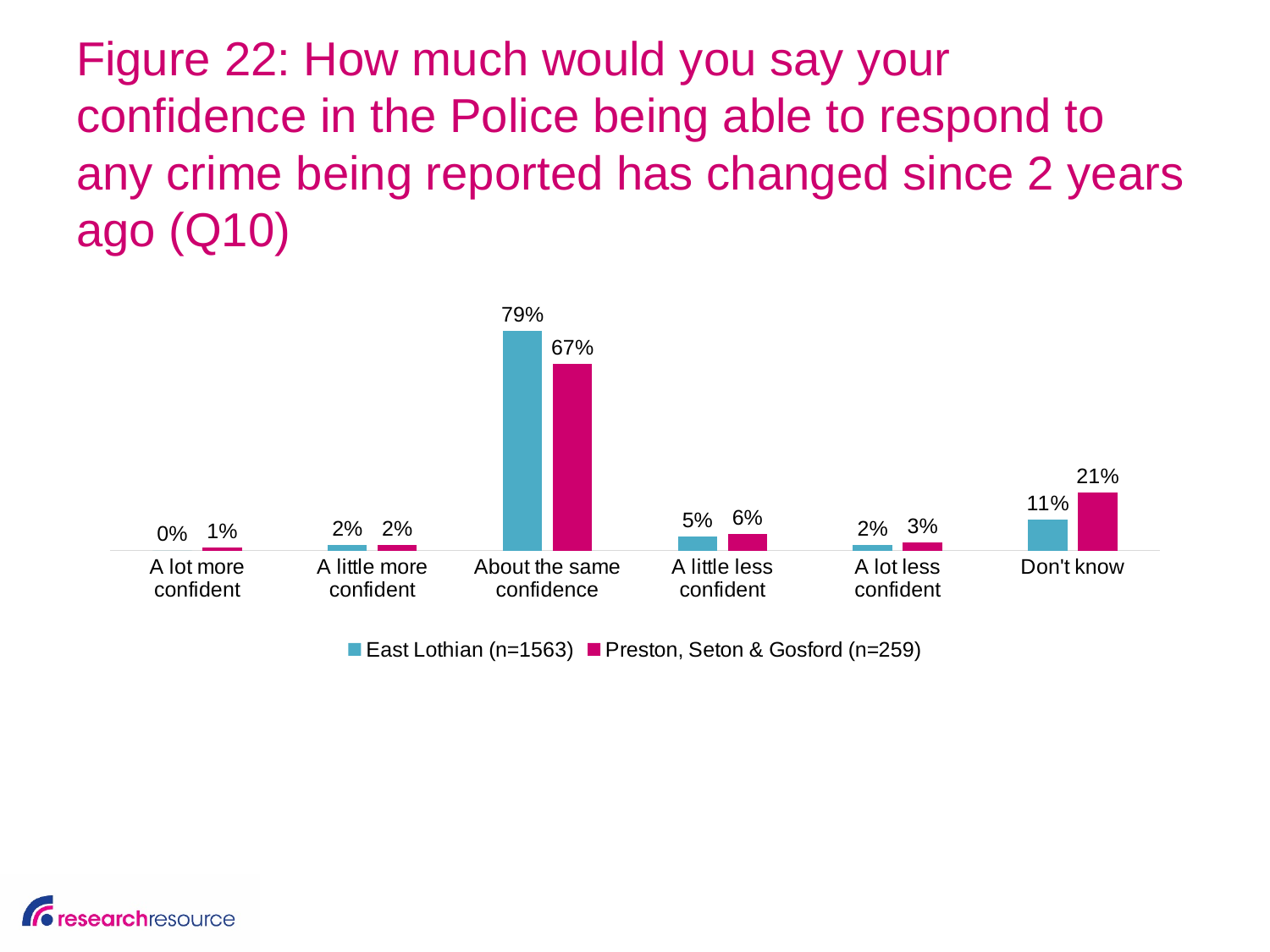
How many response categories are shown on the x axis? 6 What is the sample size (n) for the East Lothian series shown in the legend? 1563 What type of chart is shown on the slide? Bar chart Which category has the highest value for East Lothian? About the same confidence What is the value for Preston, Seton & Gosford for 'A little less confident'? 6% How many series does the legend list? 2 For 'Don't know', which series has the larger value, East Lothian or Preston, Seton & Gosford? Preston, Seton & Gosford Which category has the lowest value for Preston, Seton & Gosford? A lot more confident What is the value for East Lothian for 'A lot more confident'? 0% What percentage of East Lothian respondents said 'About the same confidence'? 79% What percentage of Preston, Seton & Gosford respondents said 'Don't know'? 21% What is the difference between East Lothian and Preston, Seton & Gosford for 'About the same confidence'? 12 percentage points